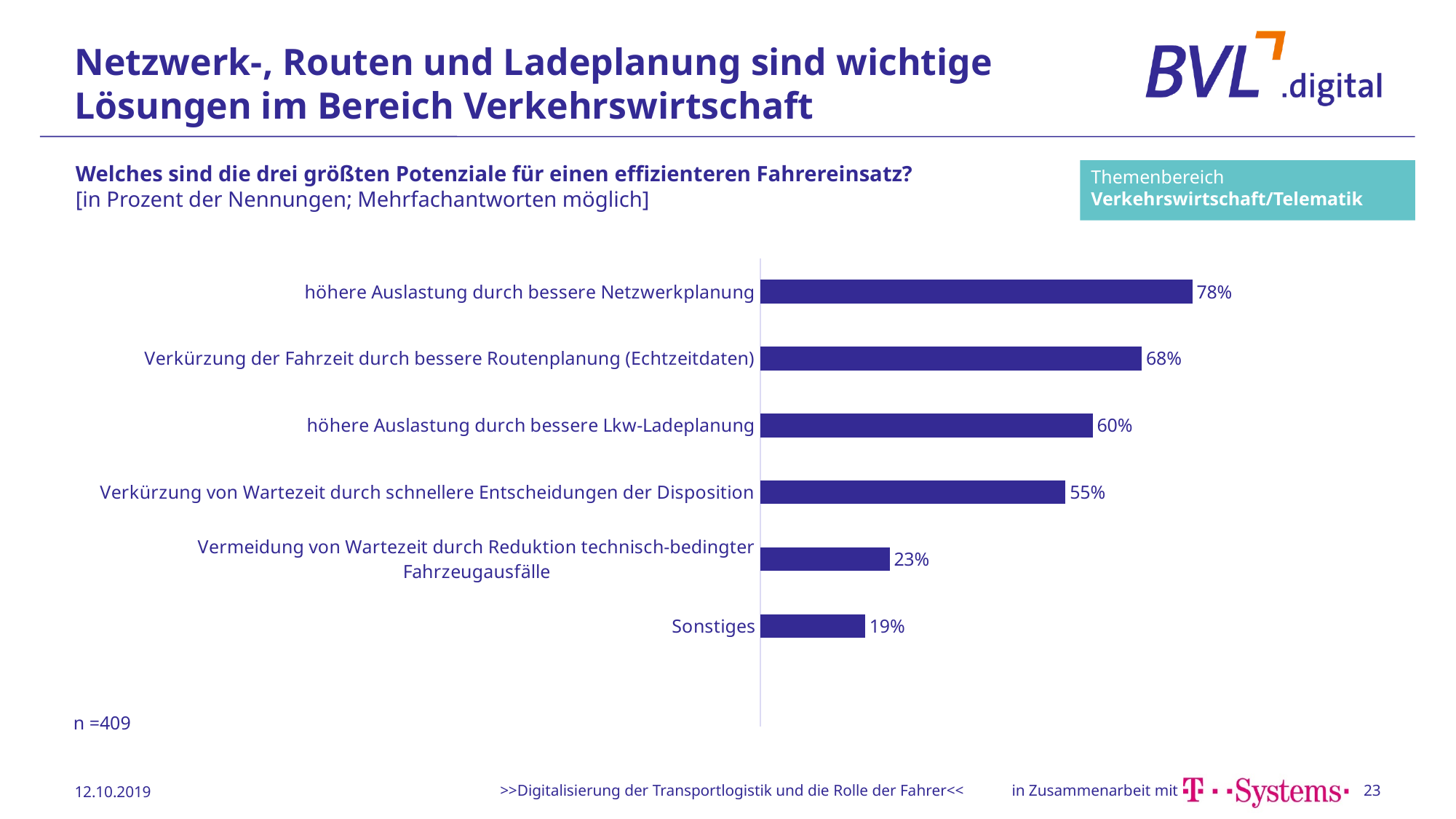
What is the value for "Vermeidung von Wartezeit durch Reduktion technisch-bedingter Fahrzeugausfälle"? 23% What is the value for "Sonstiges"? 19% What is the difference between the highest and lowest values in the chart? 59% What is the sample size (n) stated on the slide? 409 How many categories are shown in the chart? 6 What is the value for "höhere Auslastung durch bessere Netzwerkplanung"? 78% Which category has the highest value? höhere Auslastung durch bessere Netzwerkplanung What kind of chart is shown on the slide? bar chart Which is larger: "Verkürzung der Fahrzeit durch bessere Routenplanung (Echtzeitdaten)" or "höhere Auslastung durch bessere Lkw-Ladeplanung"? Verkürzung der Fahrzeit durch bessere Routenplanung (Echtzeitdaten) What is the value for "Verkürzung der Fahrzeit durch bessere Routenplanung (Echtzeitdaten)"? 68% Which category has the lowest value? Sonstiges What is the difference between "höhere Auslastung durch bessere Lkw-Ladeplanung" and "Verkürzung von Wartezeit durch schnellere Entscheidungen der Disposition"? 5%